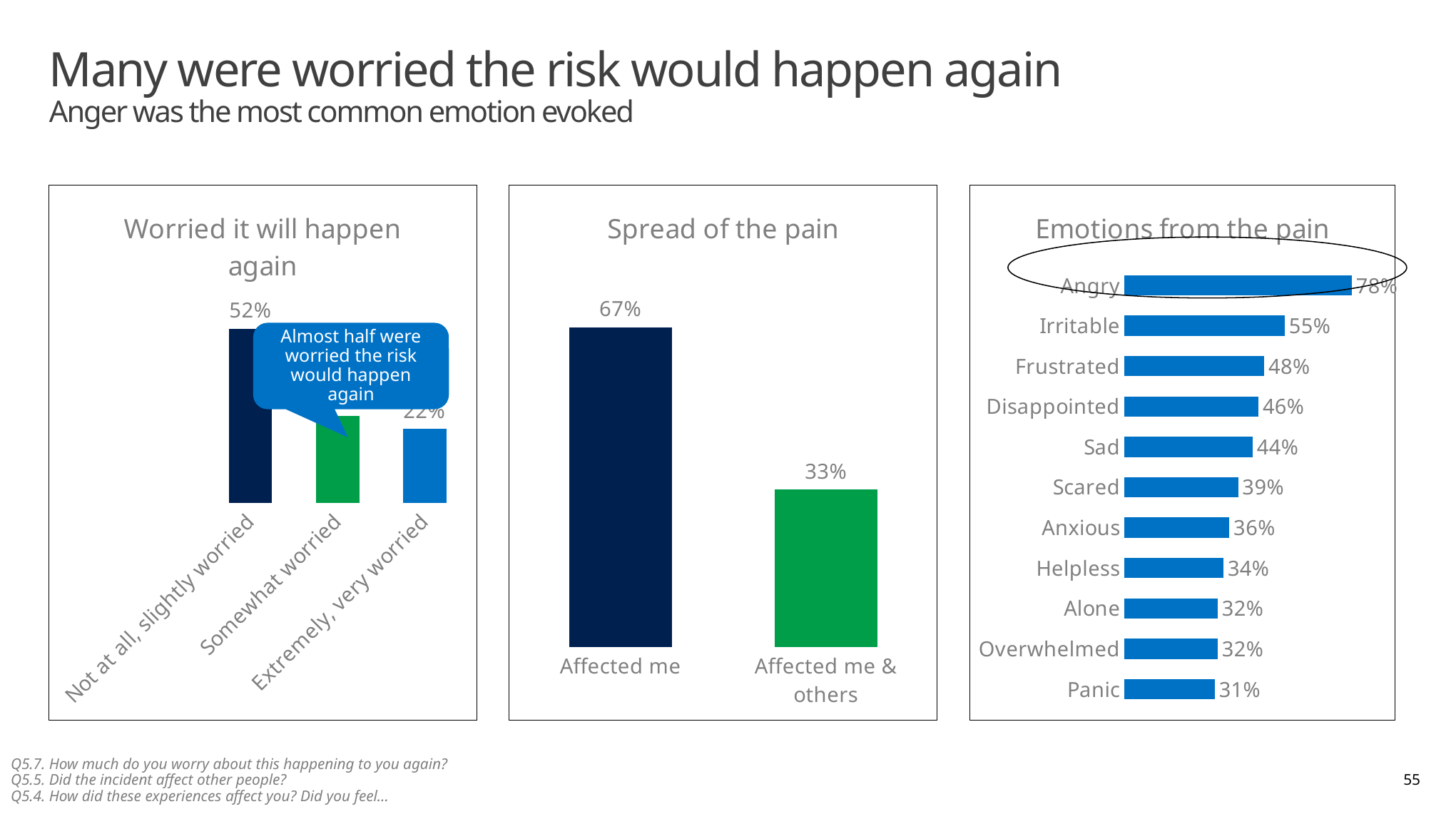
In the 'Emotions from the pain' chart, which emotion has the highest value? Angry What kind of chart is the 'Spread of the pain' chart? Bar chart In the 'Emotions from the pain' chart, how many emotions are listed? 11 In the 'Worried it will happen again' chart, what is the value for 'Extremely, very worried'? 22% In the 'Spread of the pain' chart, what is the difference between 'Affected me' and 'Affected me & others'? 34% In the 'Worried it will happen again' chart, what is the value for 'Not at all, slightly worried'? 52% In the 'Emotions from the pain' chart, what is the value for 'Frustrated'? 48% In the 'Emotions from the pain' chart, which is larger, 'Scared' or 'Helpless'? Scared In the 'Emotions from the pain' chart, which emotion has the lowest value? Panic In the 'Spread of the pain' chart, what is the value for 'Affected me'? 67% In the 'Worried it will happen again' chart, which category has the highest value? Not at all, slightly worried In the 'Emotions from the pain' chart, what is the difference between 'Angry' and 'Irritable'? 23%